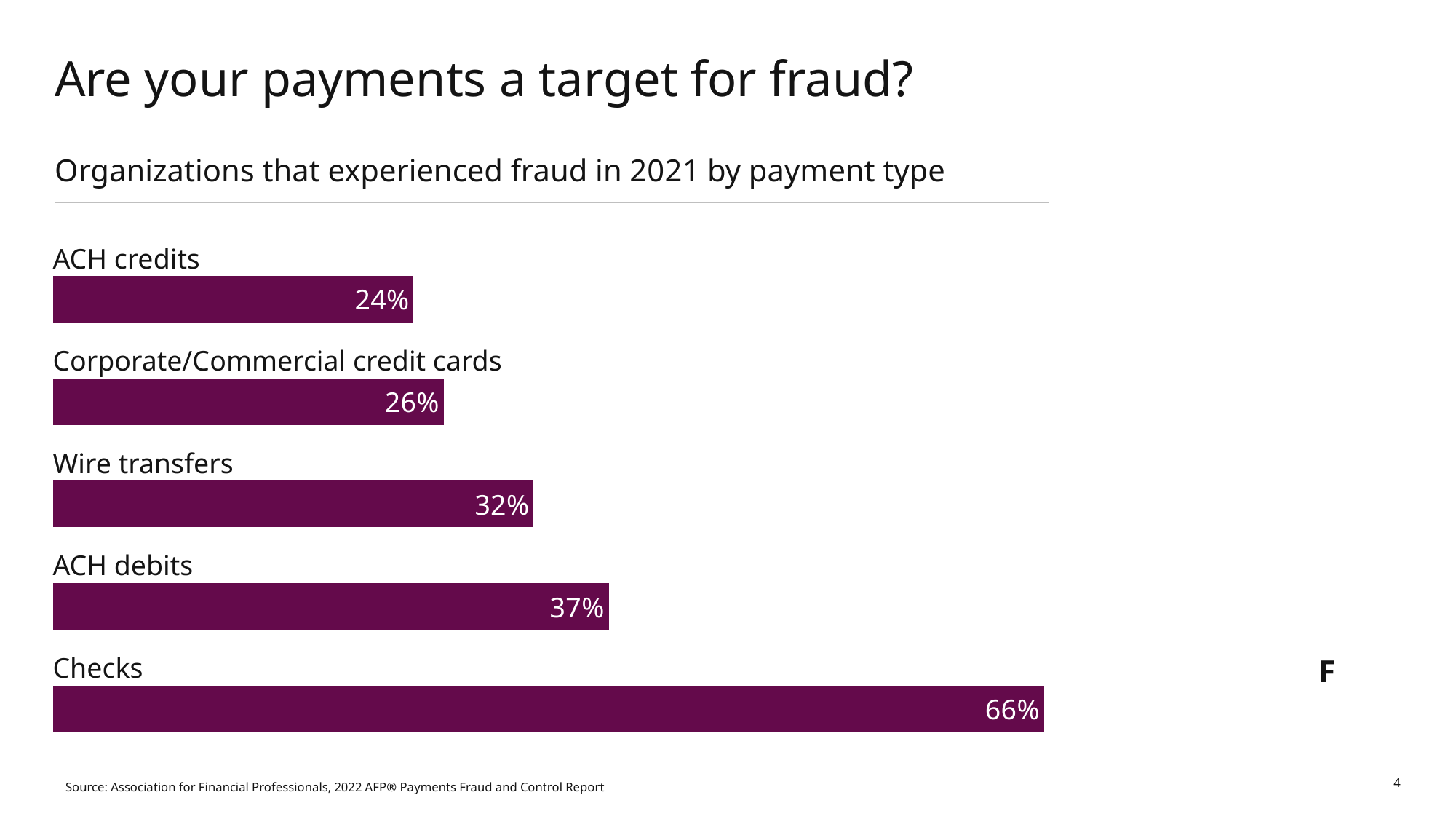
What is the subtitle describing the chart's data? Organizations that experienced fraud in 2021 by payment type Which payment type has the lowest share of organizations experiencing fraud? ACH credits What percentage of organizations experienced fraud via checks in 2021? 66% Which is larger, the value for ACH debits or the value for Wire transfers? ACH debits What is the difference between the values for Checks and ACH debits? 29% How many payment types are shown in the chart? 5 What is the value shown for Wire transfers? 32% What is the value shown for ACH credits? 24% What kind of chart is shown on the slide? Bar chart What is the value shown for Corporate/Commercial credit cards? 26% What is the difference between the values for Wire transfers and Corporate/Commercial credit cards? 6% Which payment type has the highest share of organizations experiencing fraud? Checks